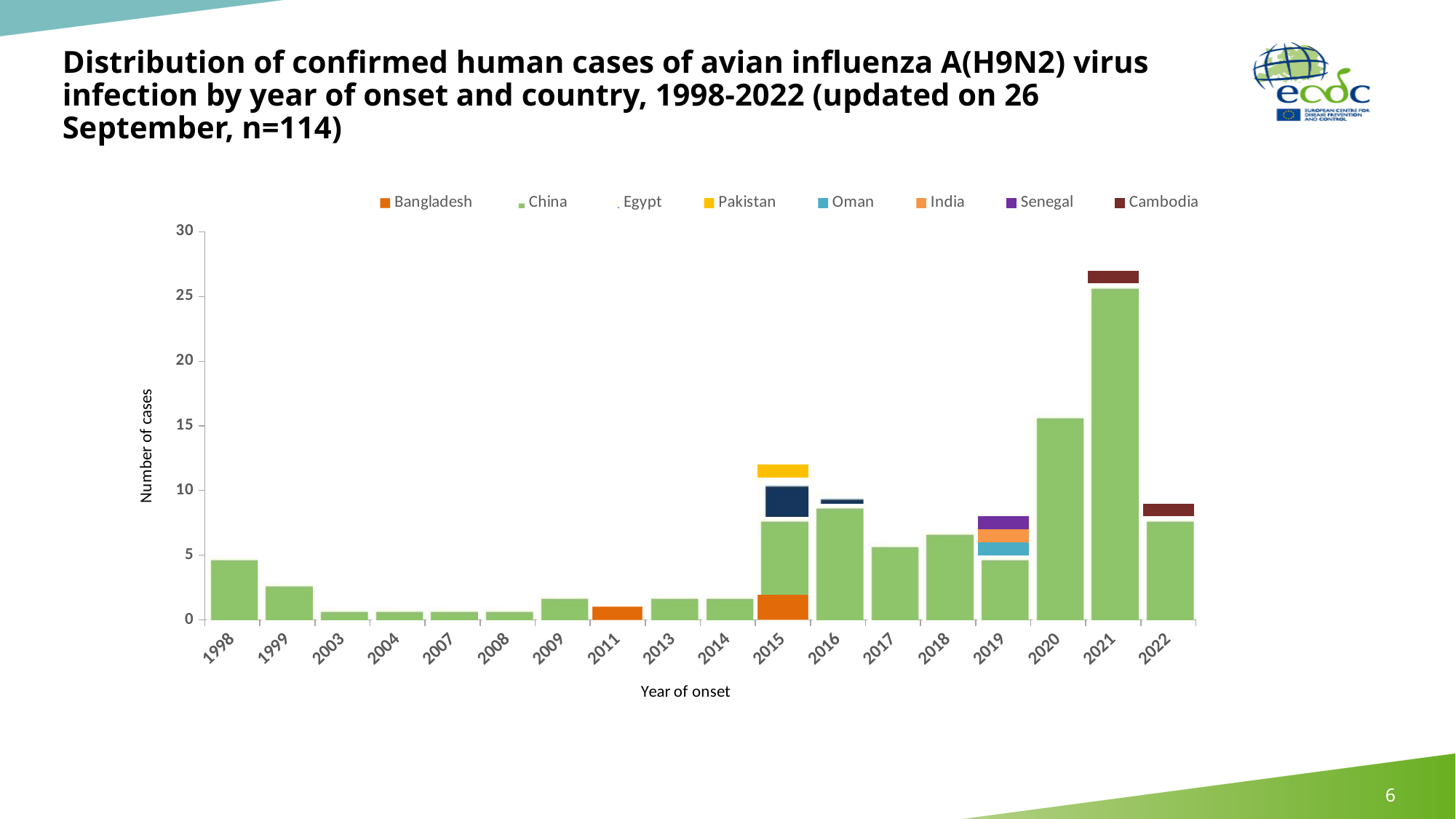
Is the total number of cases for 2019 greater or less than 10? less Do the total number of cases rise or fall from 2019 to 2021? rise Is the total number of cases for 2021 greater or less than 25? greater Is the total number of cases for 2015 greater or less than 10? greater What kind of chart is shown on the slide? Stacked bar chart How many years of onset are shown on the x axis? 18 Which year of onset has the highest total number of cases? 2021 How many series does the legend list? 8 What is the title of the y axis? Number of cases Which year has more total cases, 2015 or 2016? 2015 Which year has more total cases, 2020 or 2021? 2021